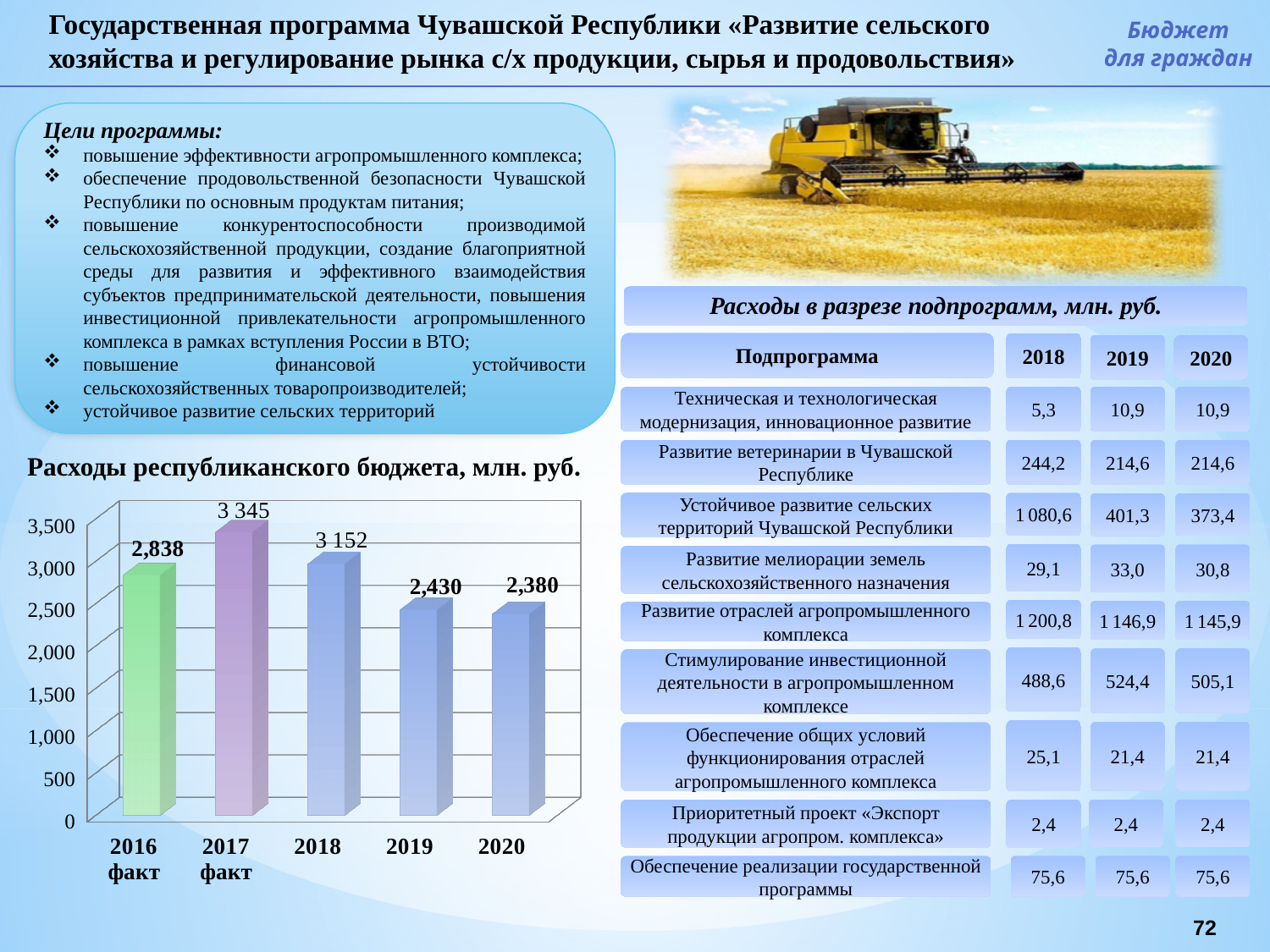
What type of chart is 'Расходы республиканского бюджета, млн. руб.'? bar chart What is the value for 2019 in the chart 'Расходы республиканского бюджета, млн. руб.'? 2,430 What is the value for 2017 факт in the chart 'Расходы республиканского бюджета, млн. руб.'? 3 345 In the chart 'Расходы республиканского бюджета, млн. руб.', what is the difference between the values for 2017 факт and 2016 факт? 507 What is the value for 2020 in the chart 'Расходы республиканского бюджета, млн. руб.'? 2,380 Which year has the highest value in the chart 'Расходы республиканского бюджета, млн. руб.'? 2017 факт How many bars are shown in the chart 'Расходы республиканского бюджета, млн. руб.'? 5 What is the value for 2016 факт in the chart 'Расходы республиканского бюджета, млн. руб.'? 2,838 In the chart 'Расходы республиканского бюджета, млн. руб.', what is the difference between the values for 2018 and 2019? 722 Which year has the lowest value in the chart 'Расходы республиканского бюджета, млн. руб.'? 2020 In the chart 'Расходы республиканского бюджета, млн. руб.', which is larger: the value for 2018 or the value for 2016 факт? 2018 In the chart 'Расходы республиканского бюджета, млн. руб.', is the value for 2019 greater or less than 2,500? less